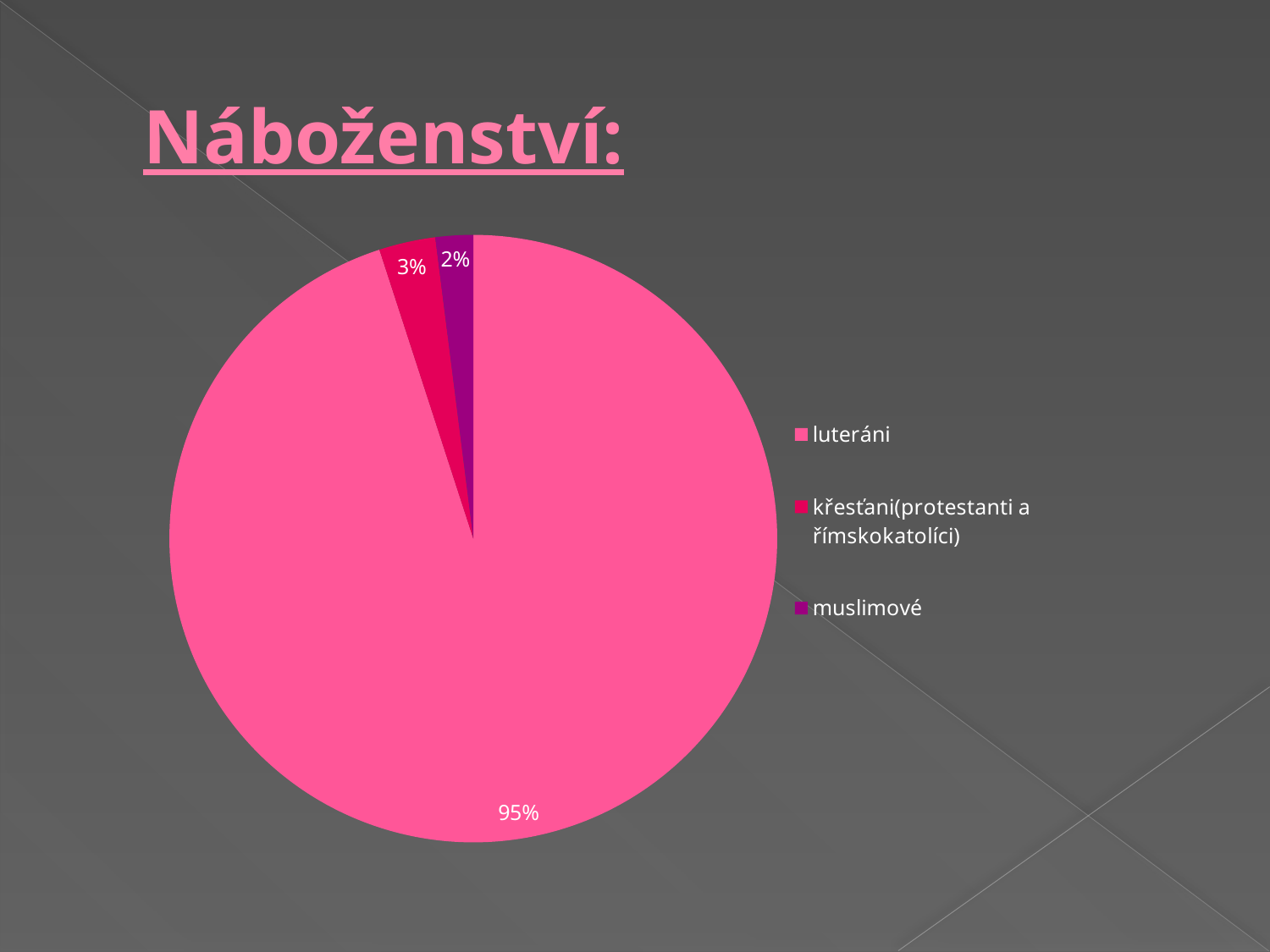
What kind of chart is shown on the slide? pie chart What share of the pie does luteráni have? 95% How many categories are shown in the pie chart? 3 Which legend entry is shown in purple? muslimové What share of the pie does muslimové have? 2% What share of the pie does křesťani(protestanti a římskokatolíci) have? 3% Which is larger, the slice for křesťani(protestanti a římskokatolíci) or the slice for muslimové? křesťani(protestanti a římskokatolíci) What is the difference in percentage points between křesťani(protestanti a římskokatolíci) and muslimové? 1 What is the difference in percentage points between luteráni and muslimové? 93 What is the title of the slide containing the chart? Náboženství: Which category has the largest slice of the pie? luteráni Which category has the smallest slice of the pie? muslimové